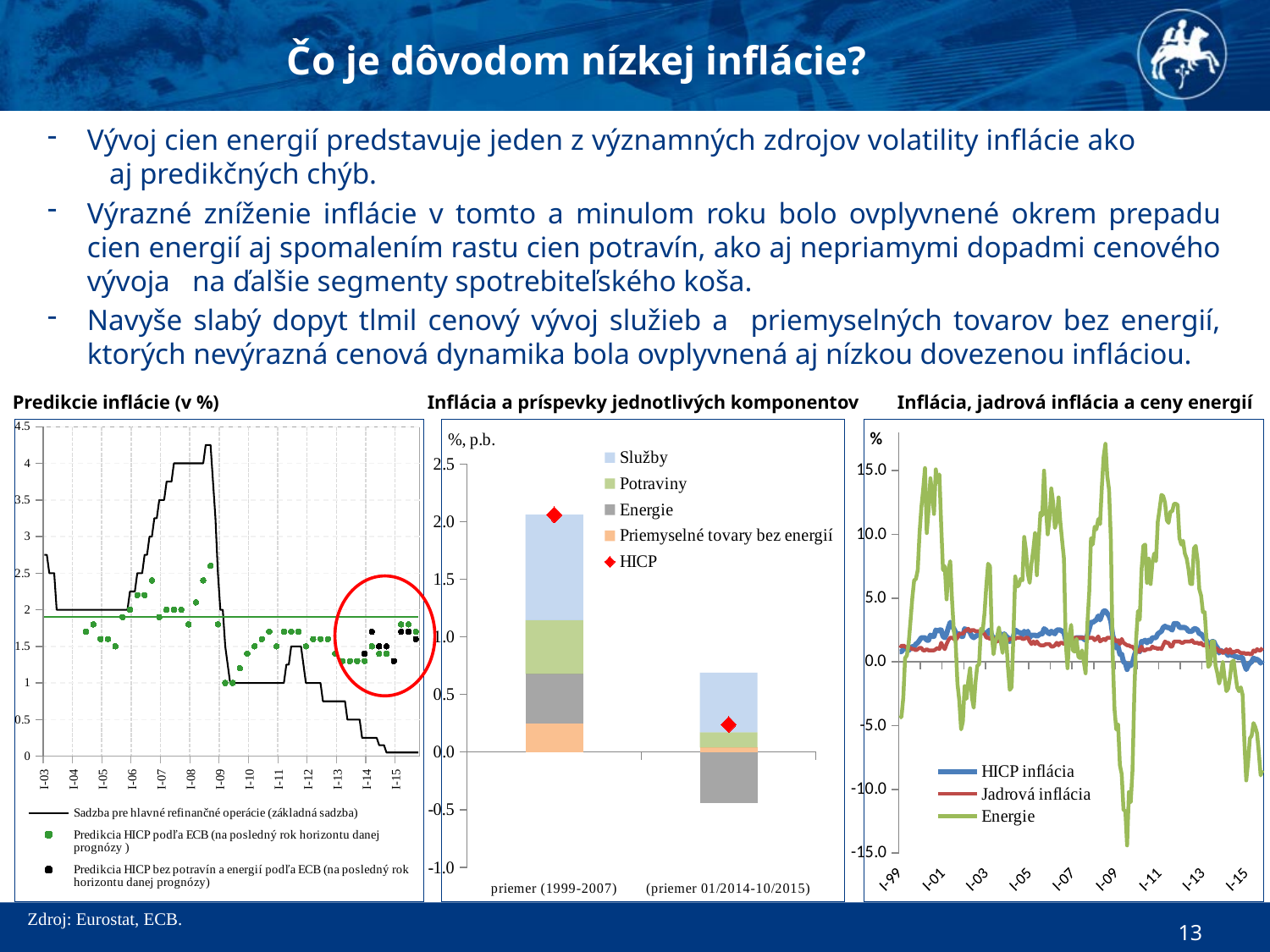
How many series does the legend of the chart 'Inflácia, jadrová inflácia a ceny energií' list? 3 In the chart 'Inflácia, jadrová inflácia a ceny energií', is the highest value of the 'Energie' series greater or less than 10.0? greater How many entries does the legend of the chart 'Inflácia a príspevky jednotlivých komponentov' list? 5 What kind of chart is 'Inflácia a príspevky jednotlivých komponentov'? Stacked bar chart In the chart 'Inflácia a príspevky jednotlivých komponentov', is the HICP value for 'priemer (1999-2007)' greater or less than 1.5? greater In the chart 'Inflácia a príspevky jednotlivých komponentov', which category has the higher HICP marker: 'priemer (1999-2007)' or '(priemer 01/2014-10/2015)'? priemer (1999-2007) In the chart 'Inflácia, jadrová inflácia a ceny energií', which series is drawn in green? Energie How many entries does the legend of the chart 'Predikcie inflácie (v %)' list? 3 In the chart 'Inflácia a príspevky jednotlivých komponentov', is the HICP value for '(priemer 01/2014-10/2015)' greater or less than 1.0? less In the chart 'Inflácia a príspevky jednotlivých komponentov', which component has a negative contribution for '(priemer 01/2014-10/2015)'? Energie What kind of chart is 'Inflácia, jadrová inflácia a ceny energií'? Line chart How many categories are shown on the x axis of the chart 'Inflácia a príspevky jednotlivých komponentov'? 2